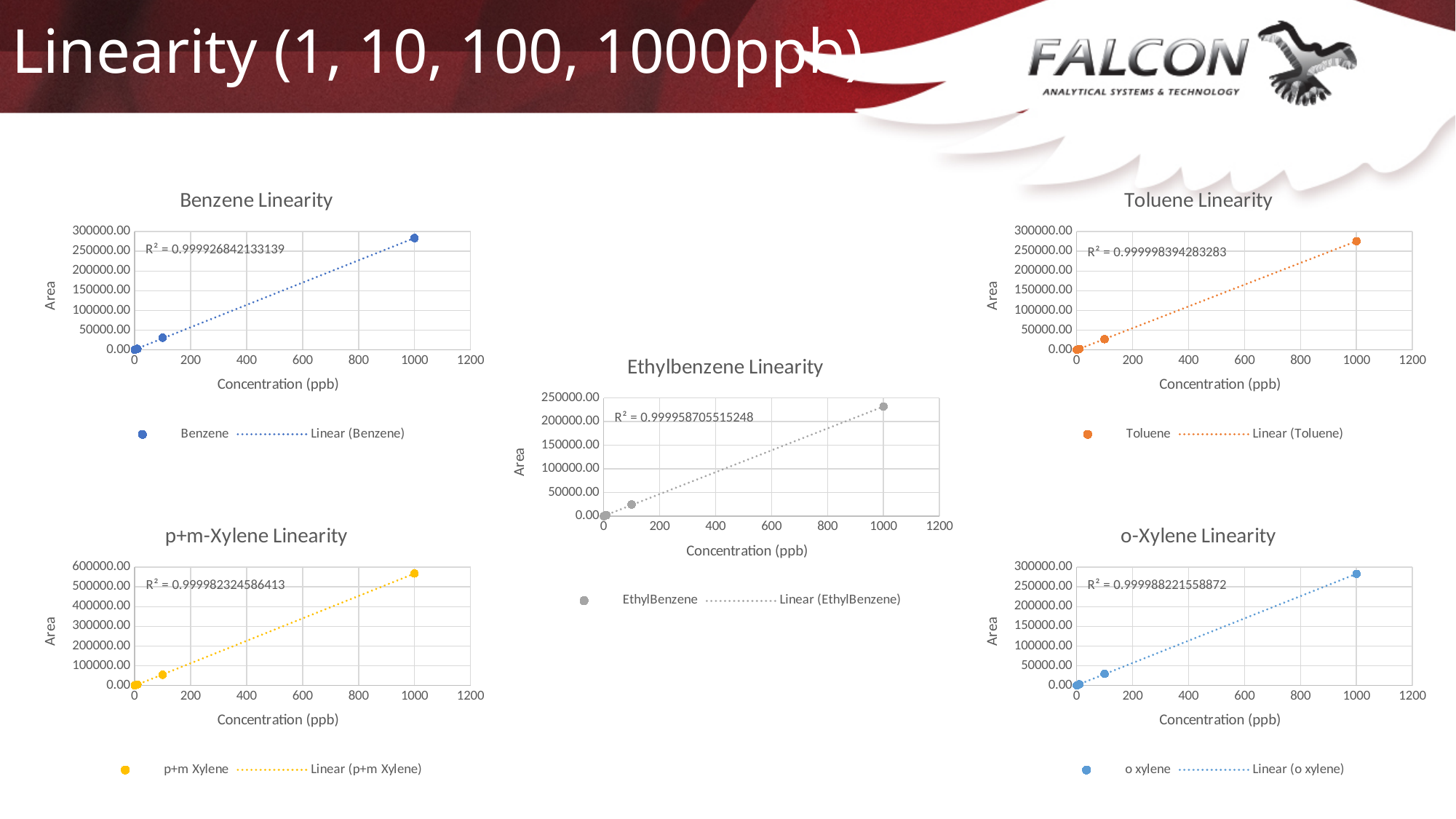
In the o-Xylene Linearity chart, what R² value is printed? R² = 0.999988221558872 In the Toluene Linearity chart, what R² value is printed? R² = 0.999998394283283 What is the x-axis title of the Benzene Linearity chart? Concentration (ppb) In the Toluene Linearity chart, does the area rise or fall as concentration increases? rise What kind of chart is the Benzene Linearity chart? scatter chart How many linearity charts are shown on the slide? 5 In the Ethylbenzene Linearity chart, is the area at 1000 ppb greater or less than 250000.00? less In the Benzene Linearity chart, what R² value is printed? R² = 0.999926842133139 In the p+m-Xylene Linearity chart, what R² value is printed? R² = 0.999982324586413 In the Ethylbenzene Linearity chart, what R² value is printed? R² = 0.999958705515248 In the p+m-Xylene Linearity chart, is the area at 1000 ppb greater or less than 500000.00? greater How many entries does the legend of the o-Xylene Linearity chart list? 2